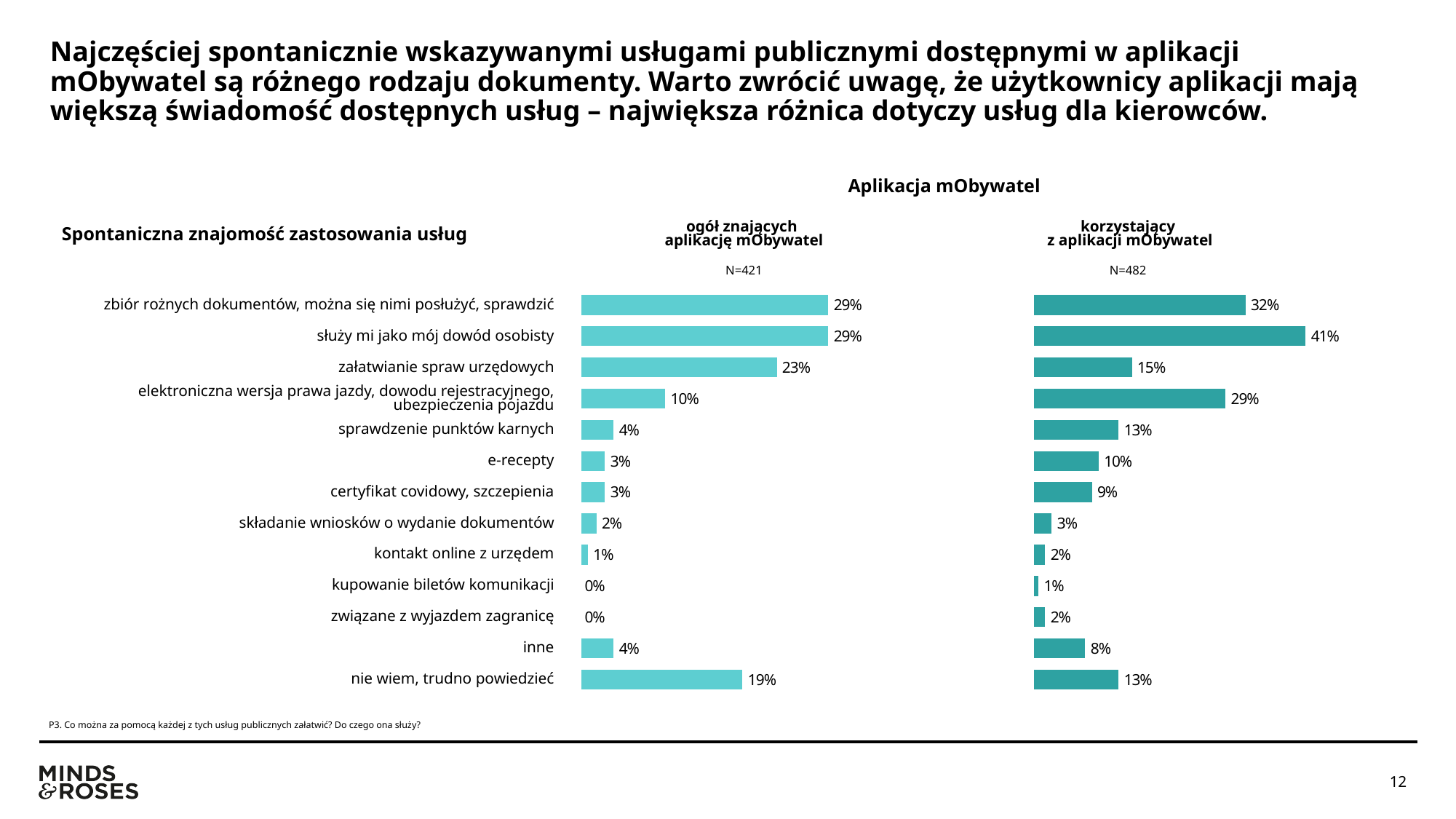
In the 'korzystający z aplikacji mObywatel' chart, which category has the highest value? służy mi jako mój dowód osobisty In the 'ogół znających aplikację mObywatel' chart, what is the value for 'załatwianie spraw urzędowych'? 23% In the 'ogół znających aplikację mObywatel' chart, what is the value for 'nie wiem, trudno powiedzieć'? 19% How many categories are listed in the charts? 13 What kind of chart is used on this slide? Bar chart What is the sample size (N) shown for the 'korzystający z aplikacji mObywatel' chart? N=482 In the 'korzystający z aplikacji mObywatel' chart, what is the value for 'sprawdzenie punktów karnych'? 13% In the 'korzystający z aplikacji mObywatel' chart, what is the value for 'elektroniczna wersja prawa jazdy, dowodu rejestracyjnego, ubezpieczenia pojazdu'? 29% What is the difference between the 'korzystający z aplikacji mObywatel' and 'ogół znających aplikację mObywatel' values for 'służy mi jako mój dowód osobisty'? 12 percentage points For 'załatwianie spraw urzędowych', which chart shows the larger value: 'ogół znających aplikację mObywatel' or 'korzystający z aplikacji mObywatel'? ogół znających aplikację mObywatel What is the difference between the 'korzystający z aplikacji mObywatel' and 'ogół znających aplikację mObywatel' values for 'elektroniczna wersja prawa jazdy, dowodu rejestracyjnego, ubezpieczenia pojazdu'? 19 percentage points In the 'ogół znających aplikację mObywatel' chart, which categories have a value of 0%? kupowanie biletów komunikacji; związane z wyjazdem zagranicę